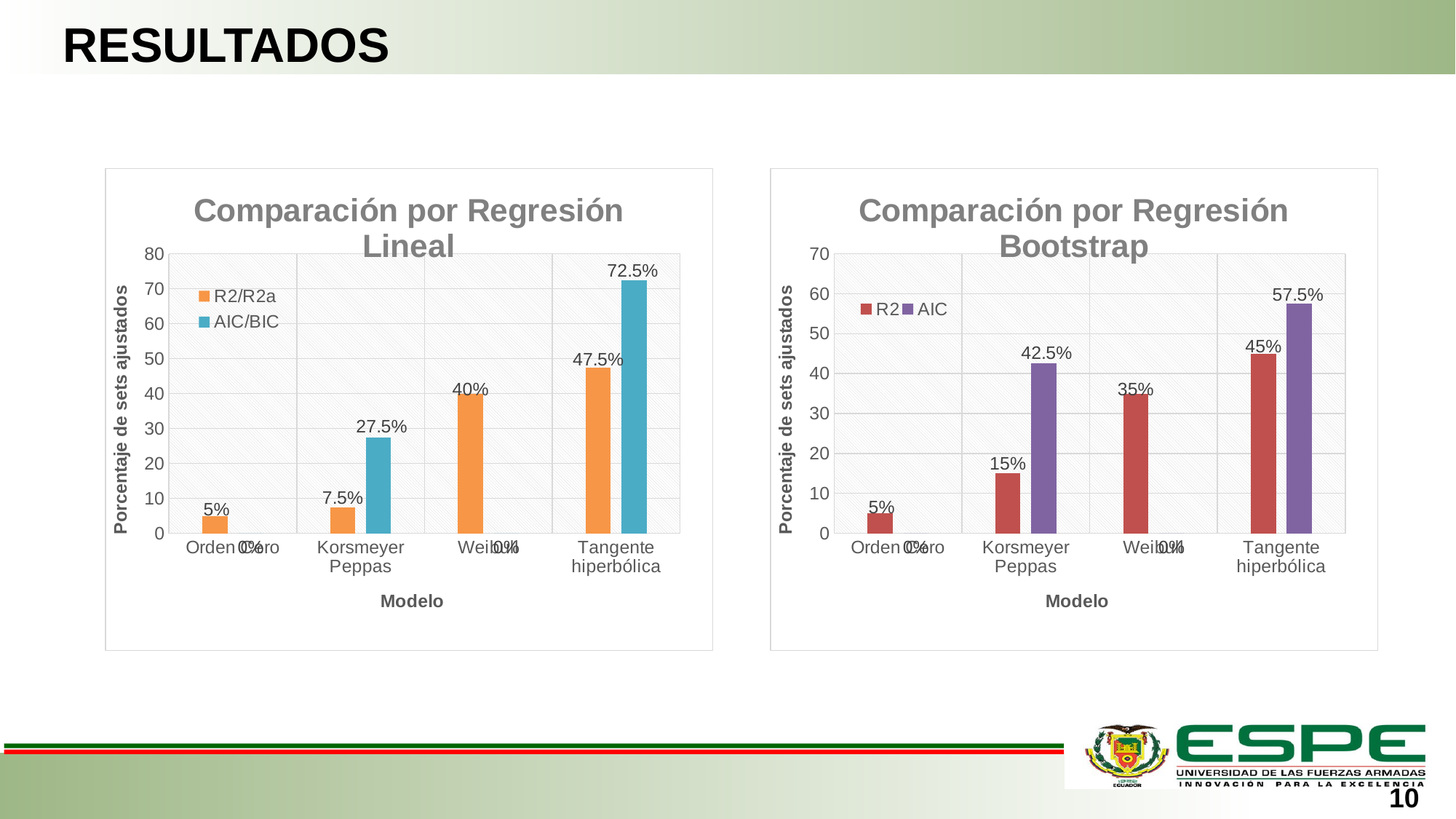
In the 'Comparación por Regresión Lineal' chart, what is the AIC/BIC value for Tangente hiperbólica? 72.5% In the 'Comparación por Regresión Lineal' chart, which model has the highest R2/R2a value? Tangente hiperbólica In the 'Comparación por Regresión Bootstrap' chart, which is larger for Tangente hiperbólica: the R2 value or the AIC value? AIC In the 'Comparación por Regresión Lineal' chart, what is the difference between the AIC/BIC and R2/R2a values for Korsmeyer Peppas? 20% How many models are shown on the x axis of the 'Comparación por Regresión Bootstrap' chart? 4 In the 'Comparación por Regresión Lineal' chart, what is the R2/R2a value for Weibull? 40% In the 'Comparación por Regresión Lineal' chart, how many series does the legend list? 2 In the 'Comparación por Regresión Bootstrap' chart, what is the R2 value for Weibull? 35% What type of chart is 'Comparación por Regresión Lineal'? Bar chart In the 'Comparación por Regresión Bootstrap' chart, what is the AIC value for Korsmeyer Peppas? 42.5% In the 'Comparación por Regresión Bootstrap' chart, which model has the lowest R2 value? Orden Cero In the 'Comparación por Regresión Bootstrap' chart, what is the difference between the AIC and R2 values for Tangente hiperbólica? 12.5%